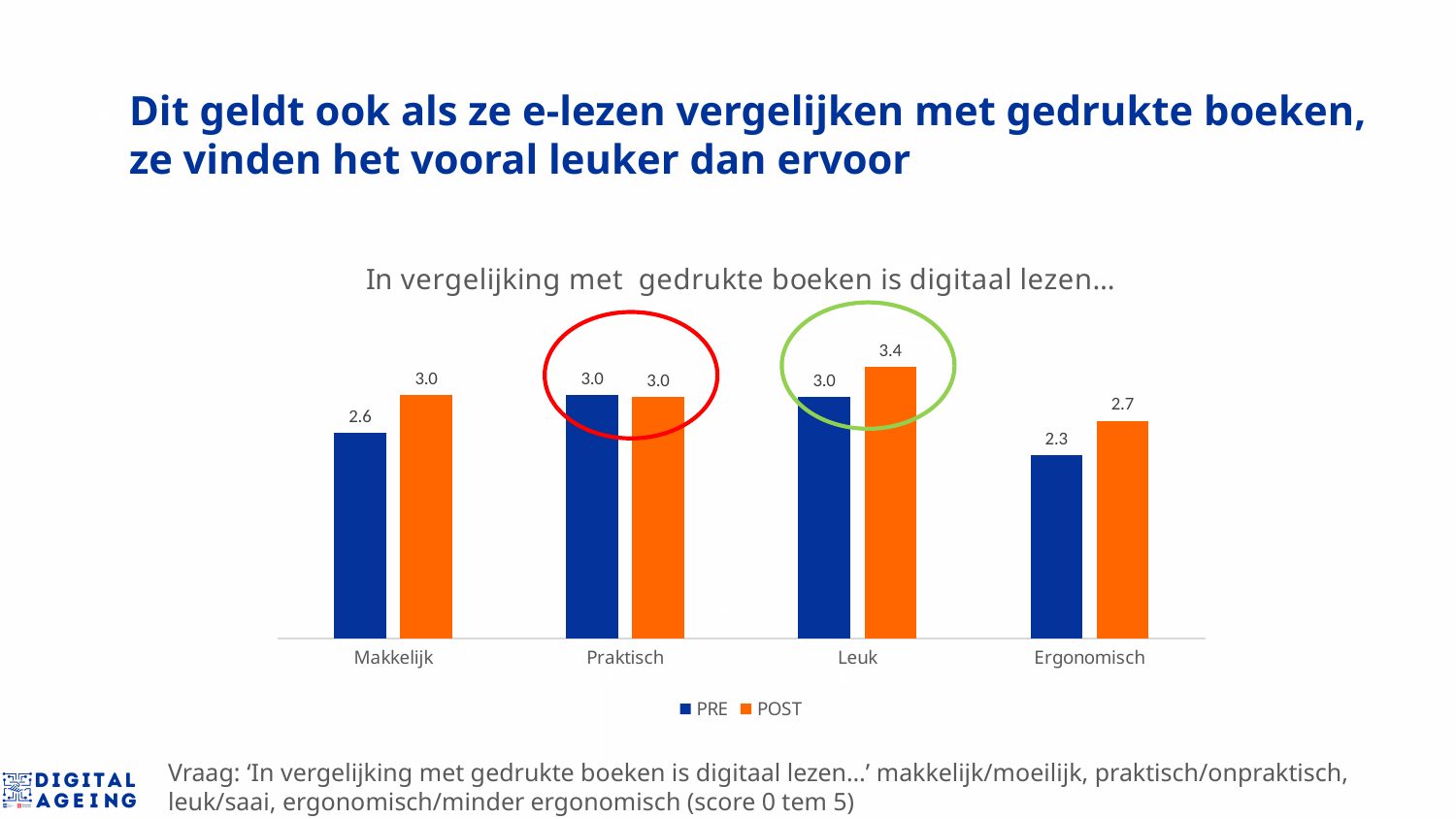
Which category has the lowest PRE value? Ergonomisch What is the difference between the POST and PRE values for Makkelijk? 0.4 What is the POST value for Praktisch? 3.0 What is the difference between the POST and PRE values for Leuk? 0.4 What is the PRE value for Ergonomisch? 2.3 What kind of chart is shown on the slide? Bar chart Which is larger for Ergonomisch, the PRE value or the POST value? POST What is the PRE value for Makkelijk? 2.6 What is the POST value for Leuk? 3.4 Which category has the highest POST value? Leuk How many categories are shown on the x axis? 4 How many series does the legend list? 2